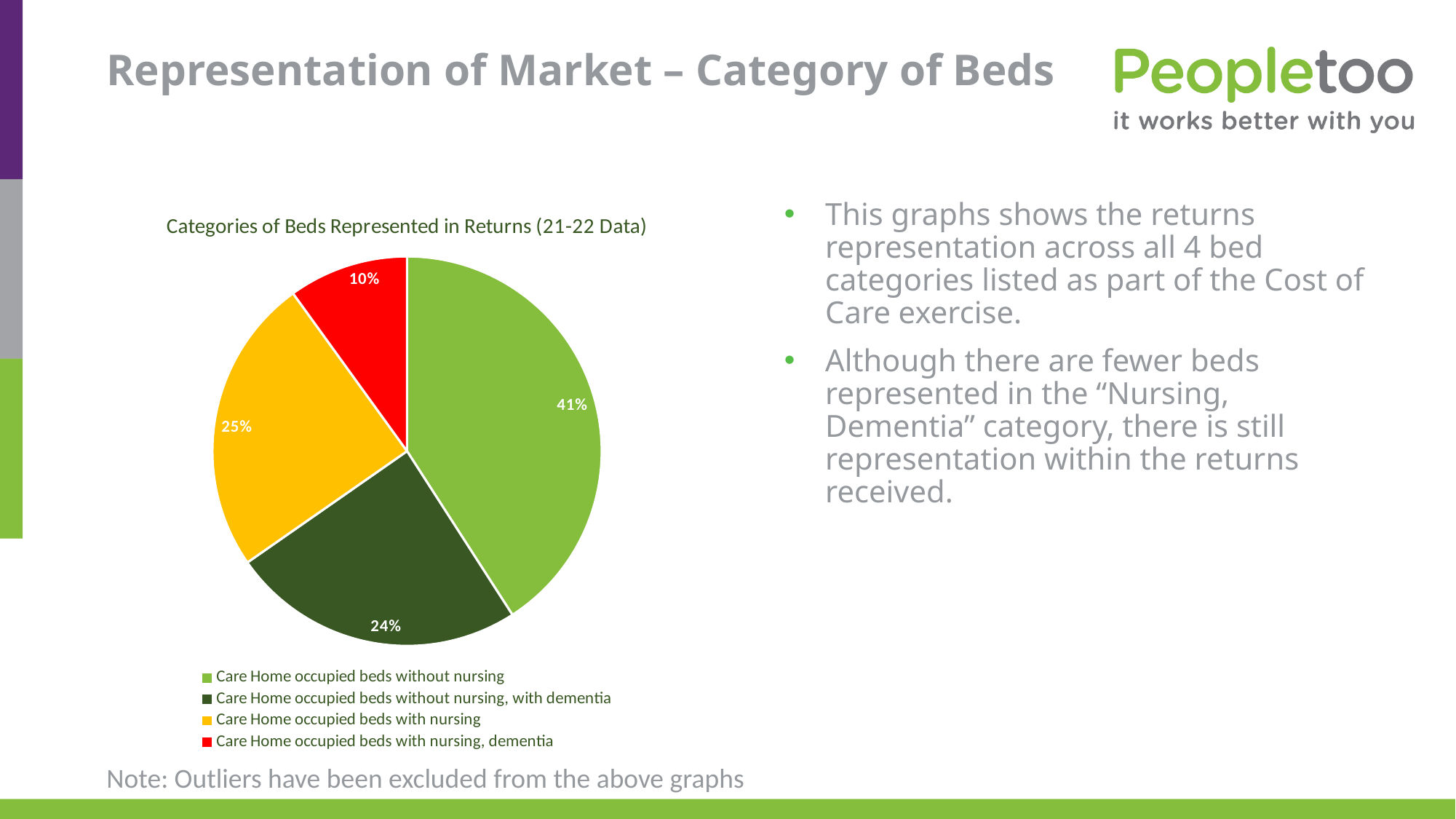
Which category has the smallest share of the pie? Care Home occupied beds with nursing, dementia Which is larger: the share for Care Home occupied beds with nursing or the share for Care Home occupied beds without nursing, with dementia? Care Home occupied beds with nursing How many categories does the legend list? 4 What colour is the slice for Care Home occupied beds with nursing, dementia? Red What share of the pie is Care Home occupied beds without nursing? 41% Which category has the largest share of the pie? Care Home occupied beds without nursing What share of the pie is Care Home occupied beds without nursing, with dementia? 24% What is the title of the chart? Categories of Beds Represented in Returns (21-22 Data) What share of the pie is Care Home occupied beds with nursing, dementia? 10% What type of chart is shown on the slide? Pie chart What is the difference in percentage points between Care Home occupied beds without nursing and Care Home occupied beds with nursing, dementia? 31 percentage points